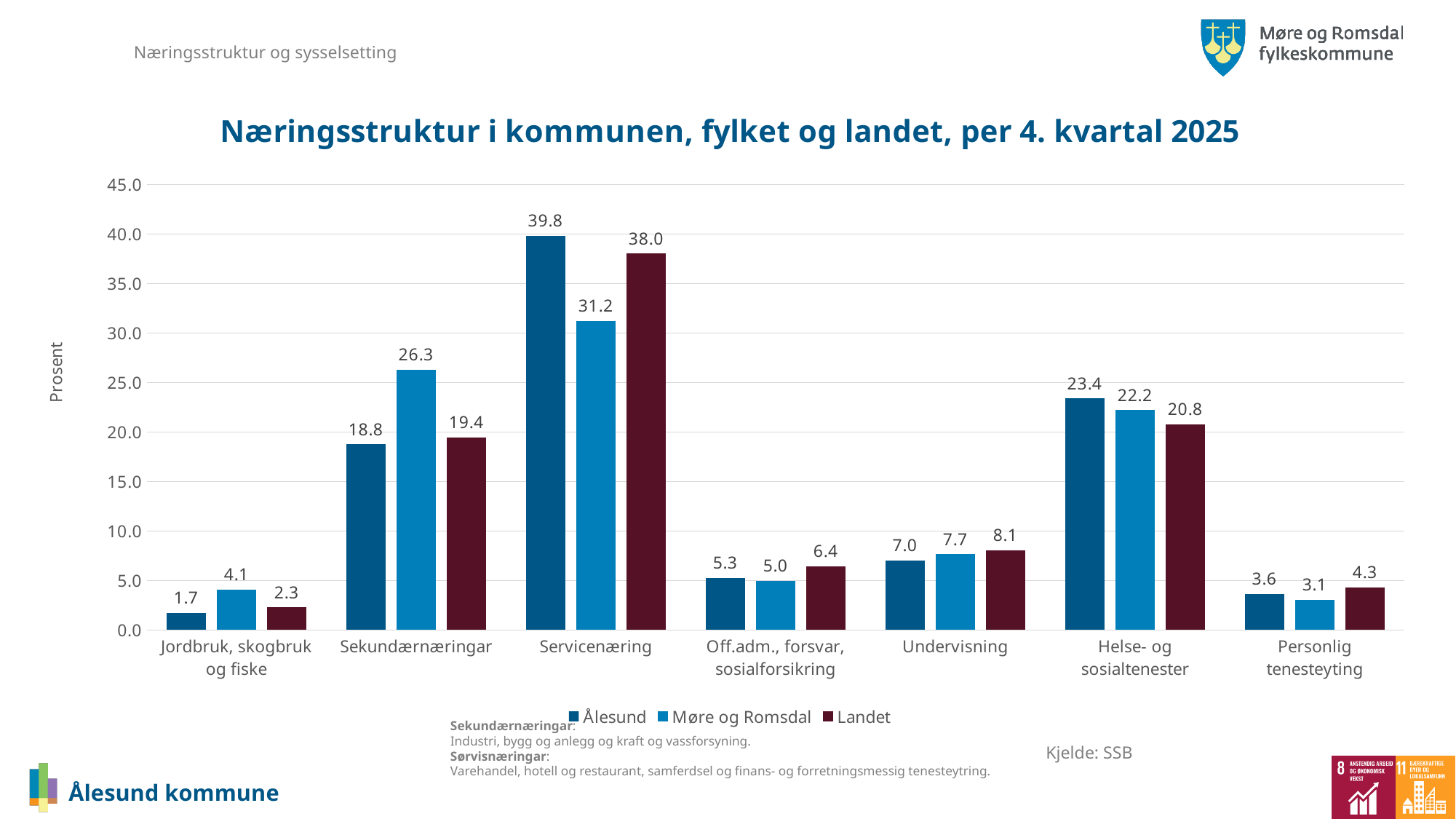
What is the value for Møre og Romsdal in Sekundærnæringar? 26.3 How many categories are shown on the x axis? 7 Which category has the lowest value for Landet? Jordbruk, skogbruk og fiske What is the title of the chart? Næringsstruktur i kommunen, fylket og landet, per 4. kvartal 2025 How many series does the legend list? 3 Which is larger in Sekundærnæringar: Ålesund or Landet? Landet What is the difference between Ålesund and Møre og Romsdal in Servicenæring? 8.6 What is the value for Ålesund in Servicenæring? 39.8 What kind of chart is shown on the slide? Bar chart What is the value for Landet in Helse- og sosialtenester? 20.8 Is the value for Landet in Servicenæring greater or less than 35.0? greater Which category has the highest value for Ålesund? Servicenæring